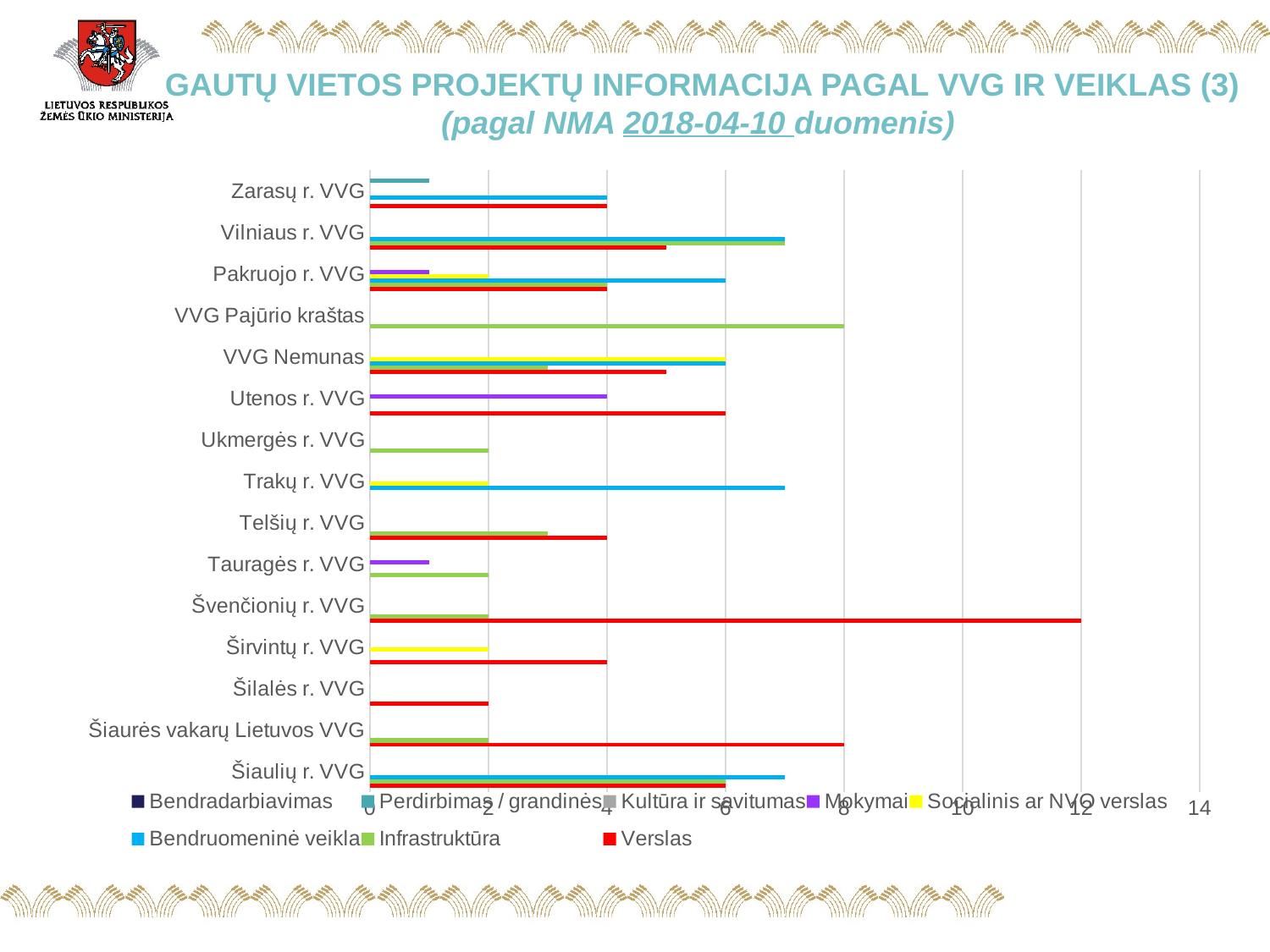
How many VVG categories are listed on the vertical axis of the chart? 15 Which VVG has the longest Verslas bar in the chart? Švenčionių r. VVG Is the Bendruomeninė veikla value for Vilniaus r. VVG greater or less than 6? greater What is the Verslas value for Utenos r. VVG? 6 Which is larger: the Verslas value for Šiaurės vakarų Lietuvos VVG or the Verslas value for Širvintų r. VVG? Šiaurės vakarų Lietuvos VVG What is the Verslas value for Švenčionių r. VVG? 12 What is the Verslas value for Šilalės r. VVG? 2 How many series does the chart legend list? 8 Is the Verslas value for VVG Nemunas greater or less than 4? greater What colour represents the Verslas series in the chart legend? red What is the Infrastruktūra value for VVG Pajūrio kraštas? 8 What kind of chart is shown on the slide? bar chart